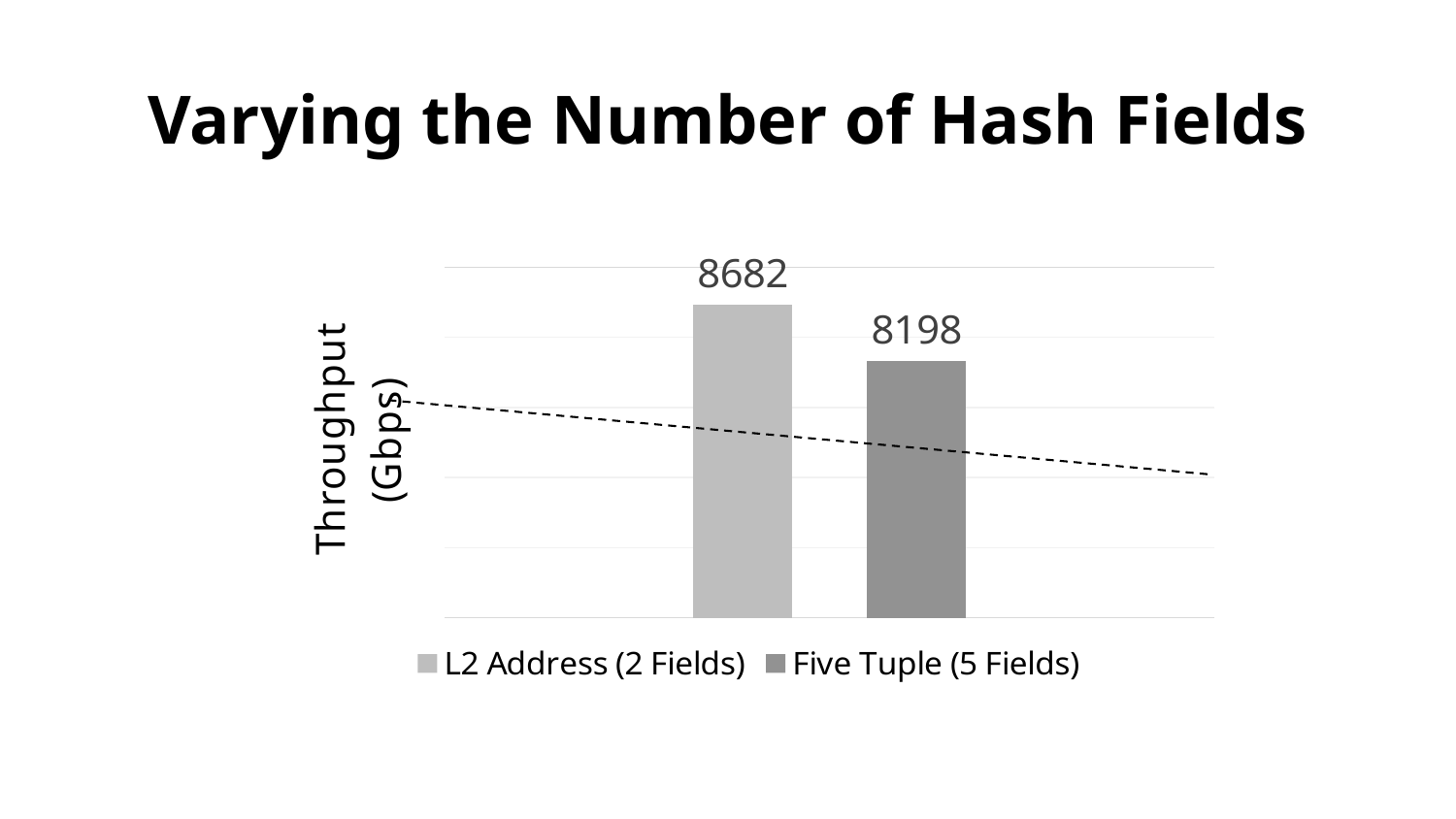
What is the throughput value for L2 Address (2 Fields)? 8682 What is the throughput value for Five Tuple (5 Fields)? 8198 How many bars are plotted in the chart? 2 What is the label on the vertical axis? Throughput (Gbps) How many series does the legend list? 2 What is the difference in throughput between L2 Address (2 Fields) and Five Tuple (5 Fields)? 484 What kind of chart is shown on the slide? Bar chart What is the title of the slide? Varying the Number of Hash Fields Which series has the lowest throughput? Five Tuple (5 Fields) Which is larger, the throughput for L2 Address (2 Fields) or for Five Tuple (5 Fields)? L2 Address (2 Fields) Which series has the highest throughput? L2 Address (2 Fields)